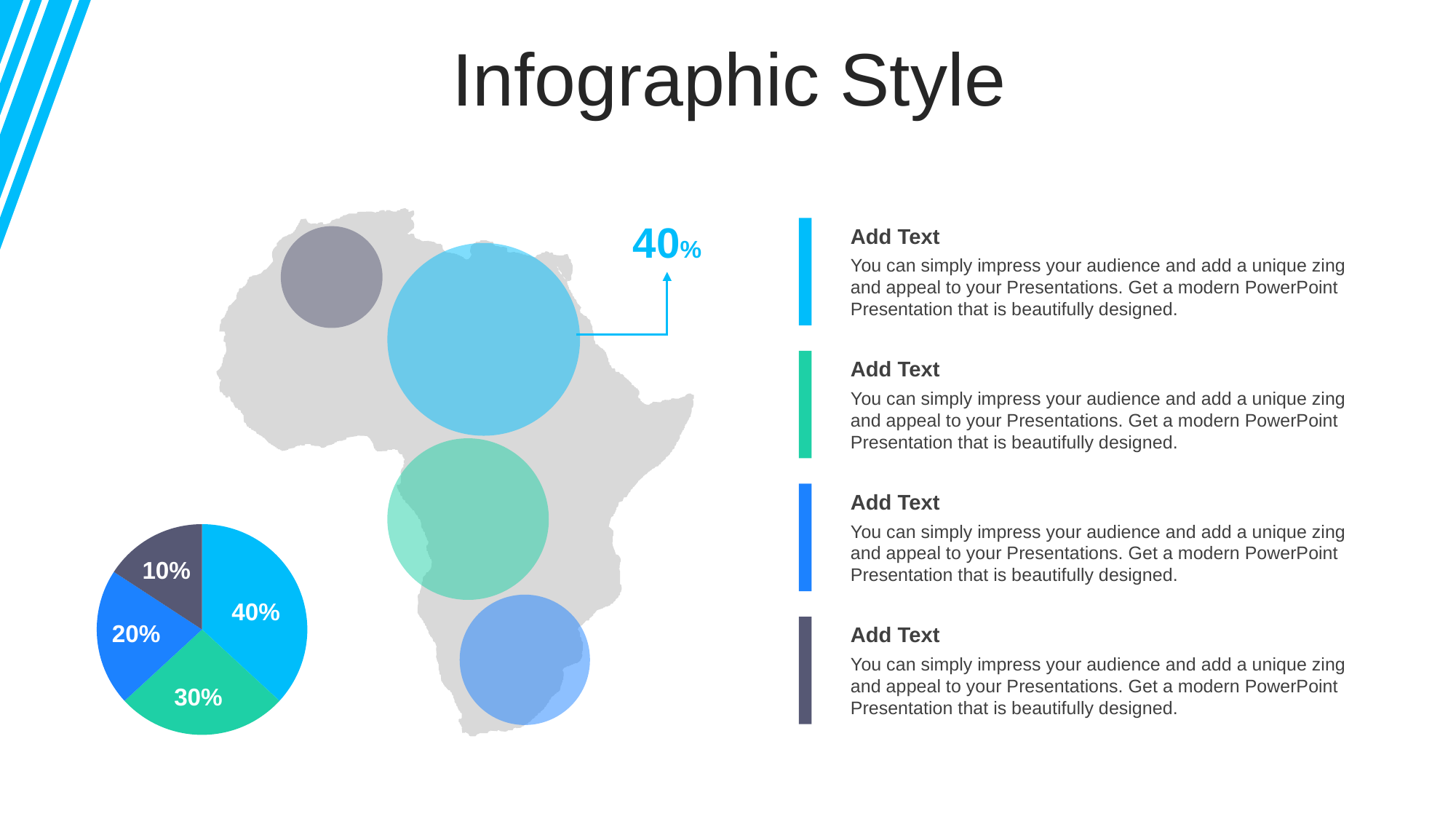
What value is shown on the dark grey slice of the pie chart? 10% What value is shown on the light blue slice of the pie chart? 40% What is the largest value shown in the pie chart? 40% In the pie chart, what is the difference between the largest slice and the smallest slice? 30% What percentage is called out next to the large light blue circle on the map? 40% What value is shown on the dark blue slice of the pie chart? 20% In the pie chart, which slice is larger, the green slice or the dark blue slice? the green slice What value is shown on the green slice of the pie chart? 30% What is the combined share of the 40% and 30% slices in the pie chart? 70% How many slices does the pie chart have? 4 What is the smallest value shown in the pie chart? 10% What kind of chart is shown at the bottom left of the slide? pie chart